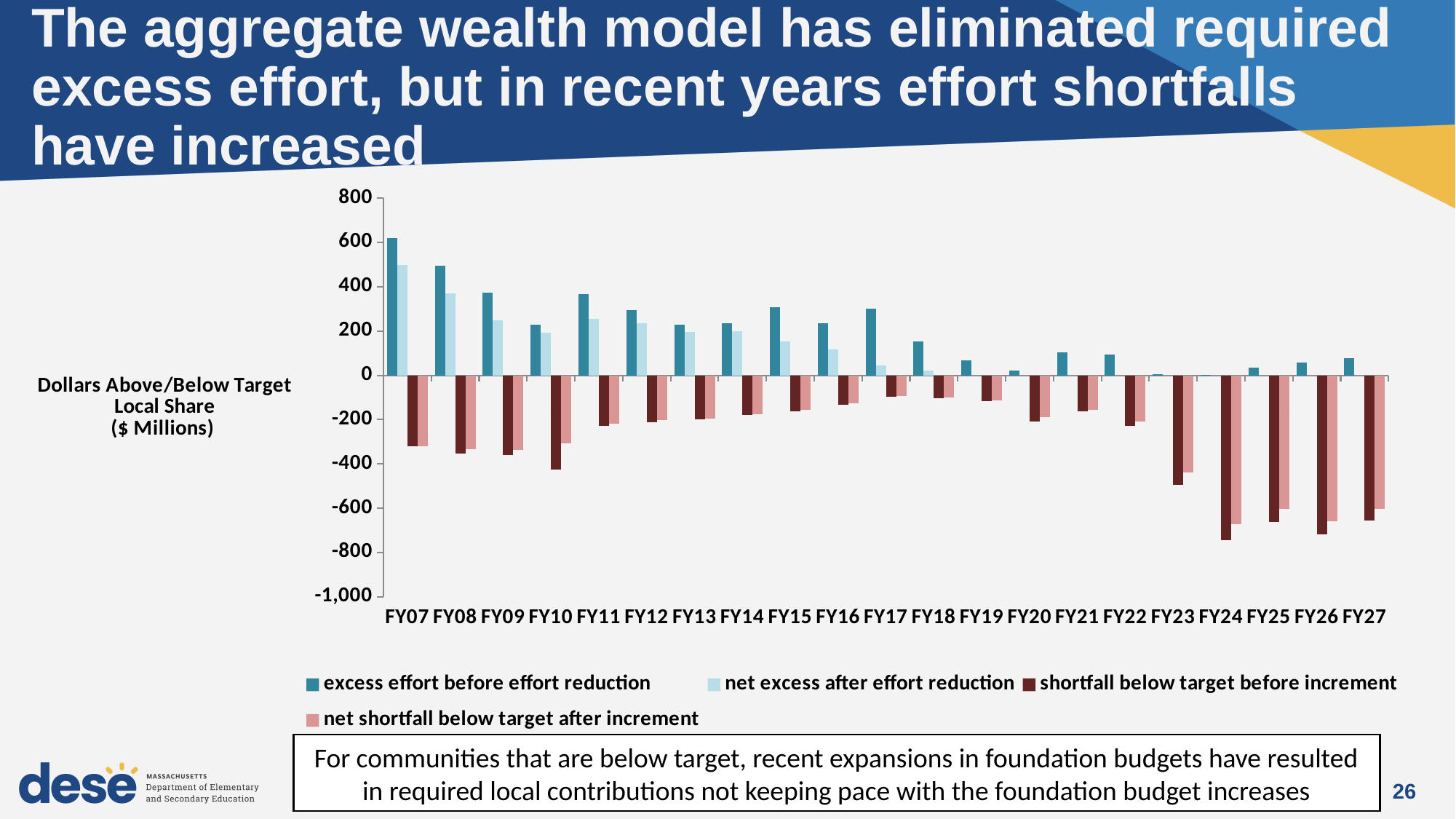
Which is larger, the 'excess effort before effort reduction' value in FY07 or in FY08? FY07 How many fiscal years are shown on the x axis of the chart? 21 Which fiscal year has the highest value for 'excess effort before effort reduction'? FY07 Is the value for 'net excess after effort reduction' in FY17 greater or less than 200? less What is the label on the vertical axis of the chart? Dollars Above/Below Target Local Share ($ Millions) What kind of chart is shown on the slide? bar chart Does the 'excess effort before effort reduction' series generally rise or fall from FY07 to FY27? fall How many series does the chart's legend list? 4 Is the value for 'excess effort before effort reduction' in FY07 greater or less than 400? greater Is the value for 'shortfall below target before increment' in FY23 greater or less than -400? less